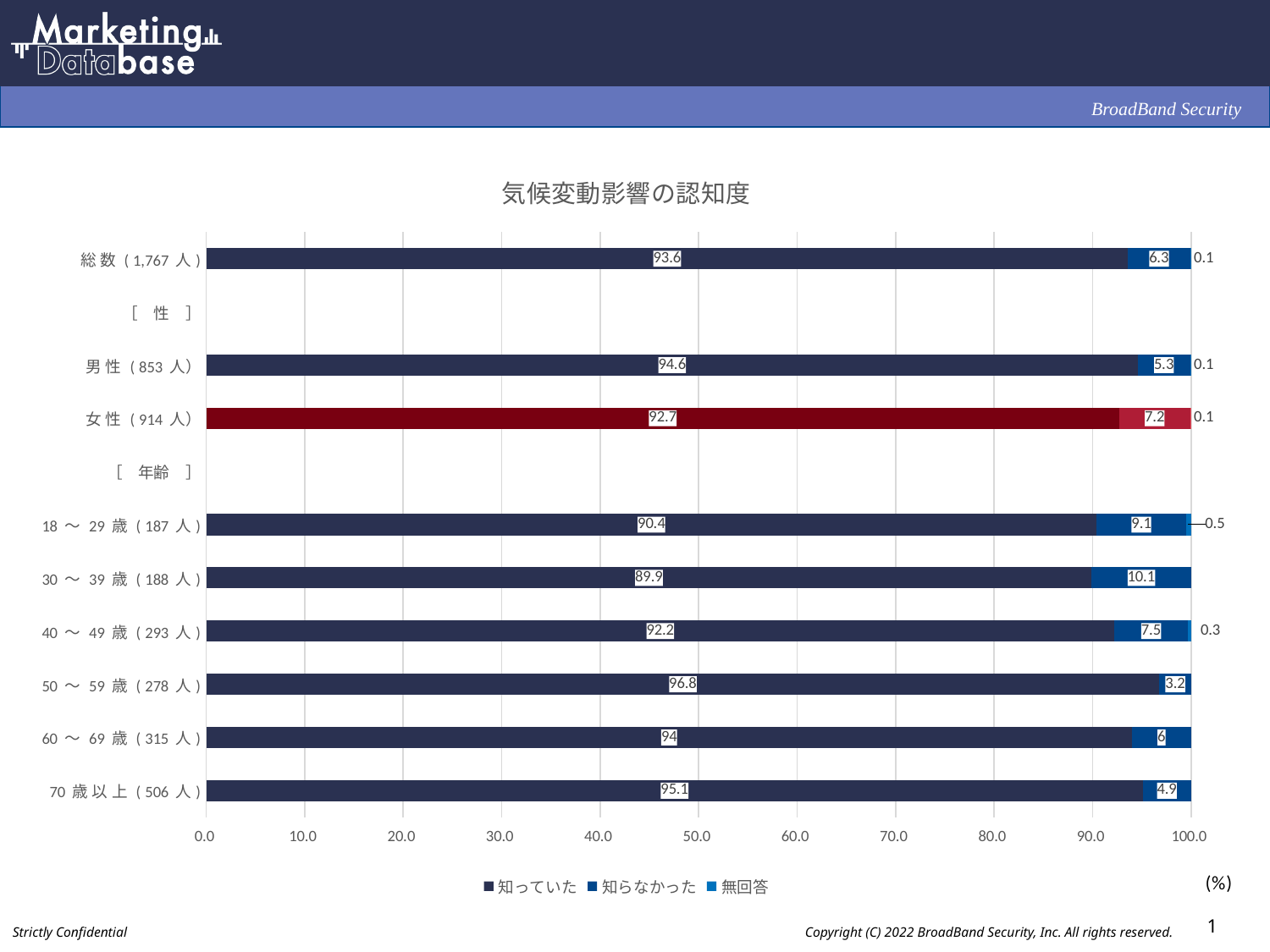
What is the value of 知らなかった for 女性 (914人)? 7.2 What is the difference between the 知っていた values for 男性 (853人) and 女性 (914人)? 1.9 What is the value of 無回答 for 18〜29歳 (187人)? 0.5 Is the 知っていた value for 70歳以上 (506人) greater or less than 90.0? greater How many series does the legend list? 3 What type of chart is shown on the slide? stacked bar chart What is the value of 知っていた for 総数 (1,767人)? 93.6 Which age group has the highest value for 知っていた? 50〜59歳 (278人) Which is larger, the 知らなかった value for 30〜39歳 (188人) or for 40〜49歳 (293人)? 30〜39歳 (188人) Which age group has the lowest value for 知っていた? 30〜39歳 (188人) What is the title of the chart? 気候変動影響の認知度 What is the value of 知らなかった for 60〜69歳 (315人)? 6